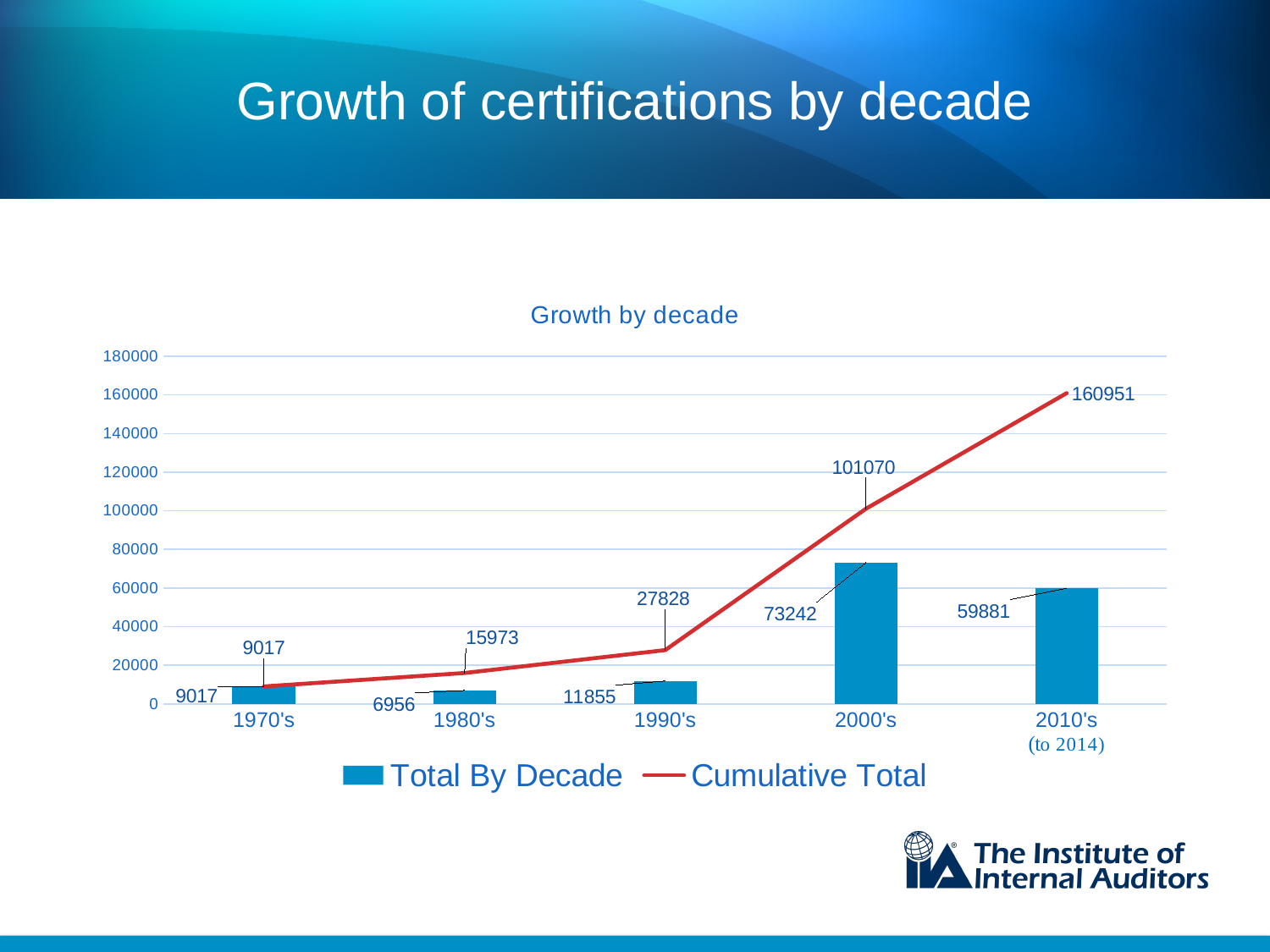
Which decade has the lowest Total By Decade value? 1980's What is the Total By Decade value for the 2000's? 73242 What is the Cumulative Total value for the 1990's? 27828 Which decade has the highest Total By Decade value? 2000's What is the title of the chart? Growth by decade What is the difference between the Total By Decade values for the 2000's and the 2010's? 13361 What is the Cumulative Total value for the 2010's? 160951 How many decades are shown on the x axis? 5 What is the Total By Decade value for the 1980's? 6956 Which is larger, the Total By Decade value for the 1970's or for the 1990's? 1990's Does the Cumulative Total line rise or fall from the 1970's to the 2010's? rise How many series does the legend list? 2